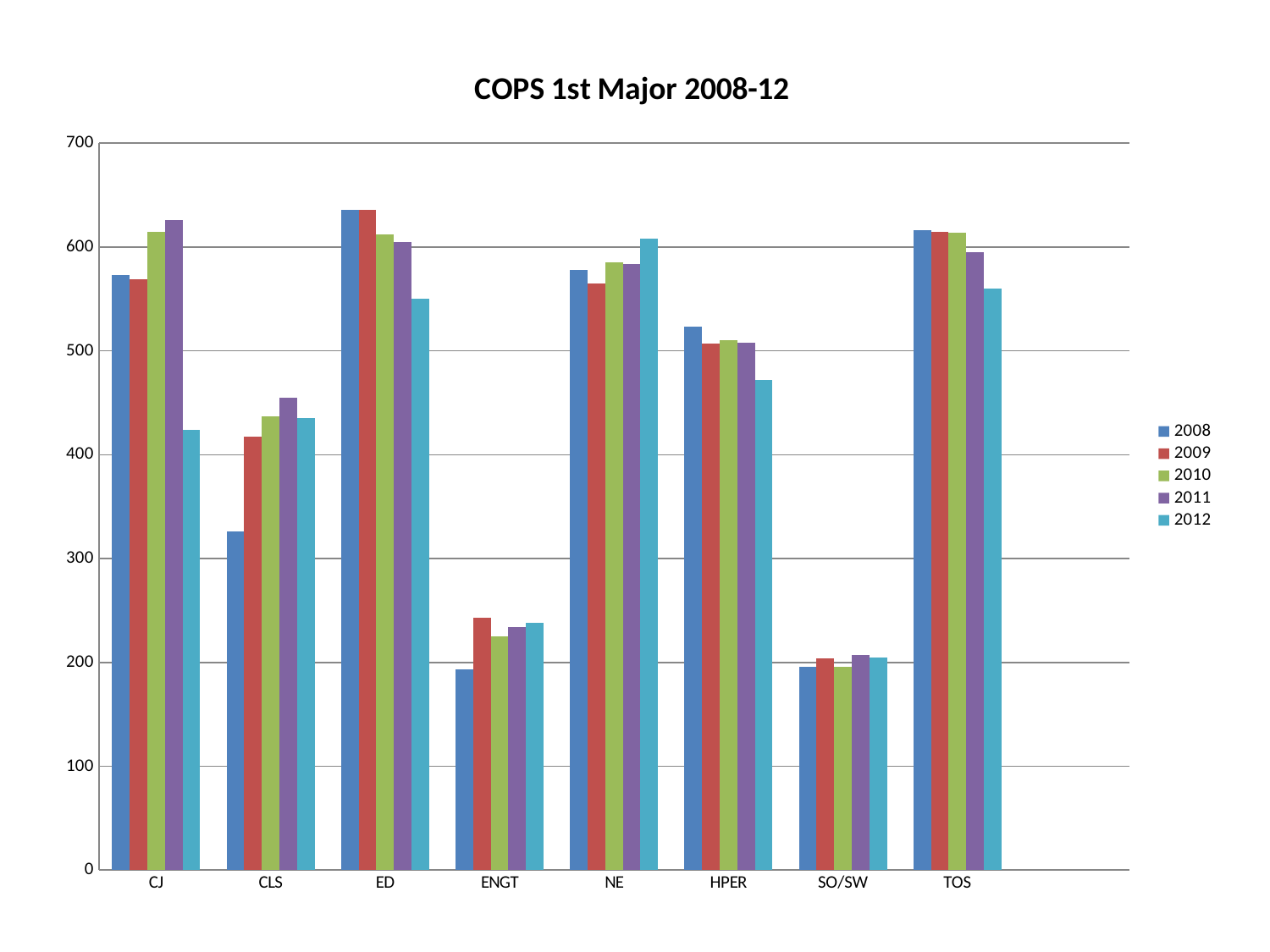
What is the title of the chart? COPS 1st Major 2008-12 Is the value for CJ in 2012 greater or less than 500? less Which category has the lowest value for 2012? SO/SW What kind of chart is shown on the slide? bar chart Is the value for HPER in 2012 greater or less than 500? less How many series does the legend list? 5 For CJ, which is larger: the 2011 value or the 2012 value? 2011 Which category has the highest value for 2008? ED Is the value for TOS in 2012 greater or less than 500? greater How many categories are shown on the x axis? 8